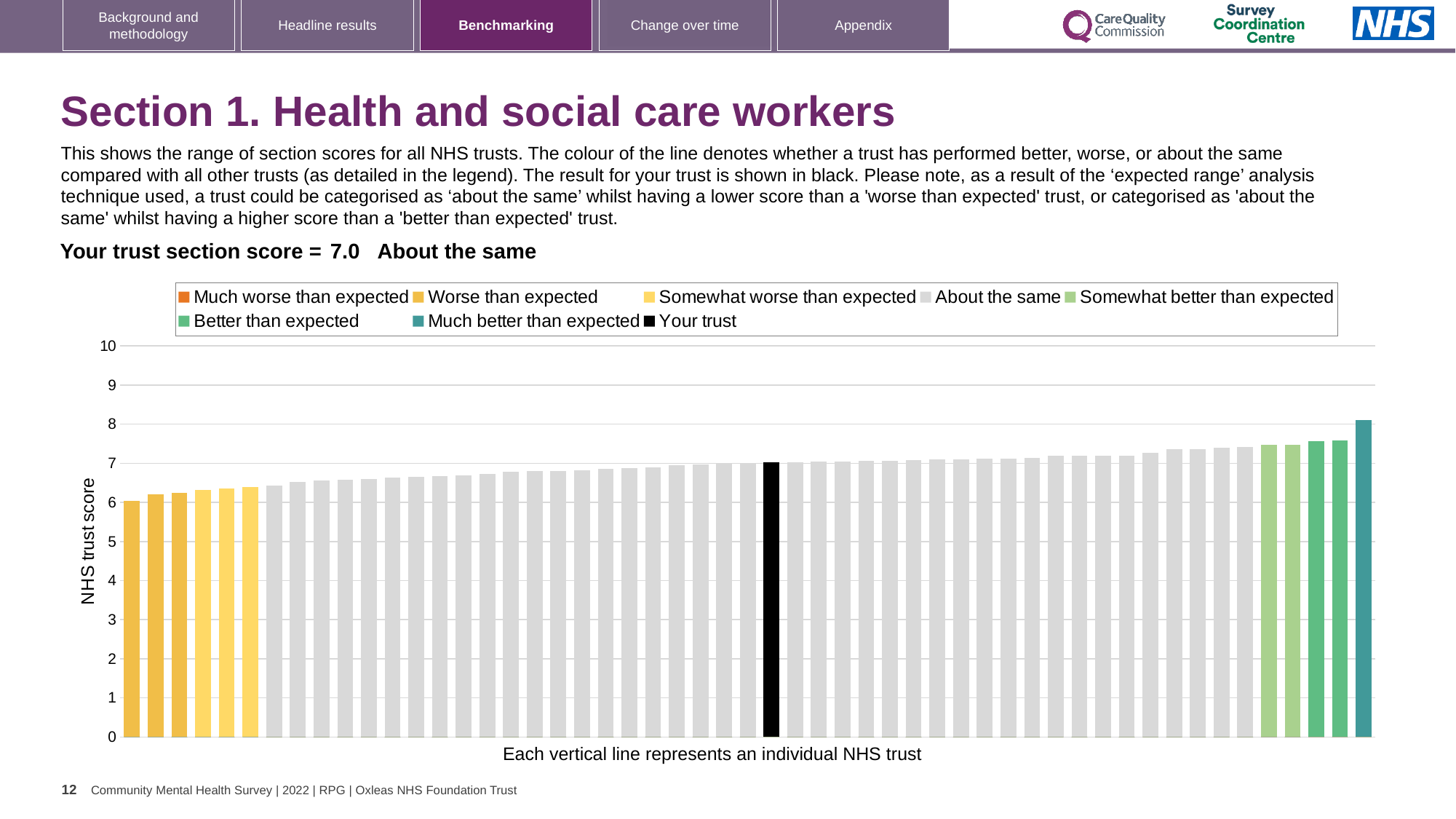
Which legend category does the shortest bar belong to? Worse than expected How many entries does the chart legend list? 8 How many bars are coloured as 'Much better than expected'? 1 Is the value of the black bar (your trust) greater or less than 5? greater Which performance category is your trust placed in, according to the text above the chart? About the same Do the bar values rise or fall from left to right along the x axis? rise What is the label on the vertical axis of the chart? NHS trust score Which legend category does the tallest bar belong to? Much better than expected Is the value of the shortest bar greater or less than 7? less What is your trust's section score as printed on the slide? 7.0 What kind of chart is shown on the slide? bar chart How many bars are coloured as 'Better than expected'? 2